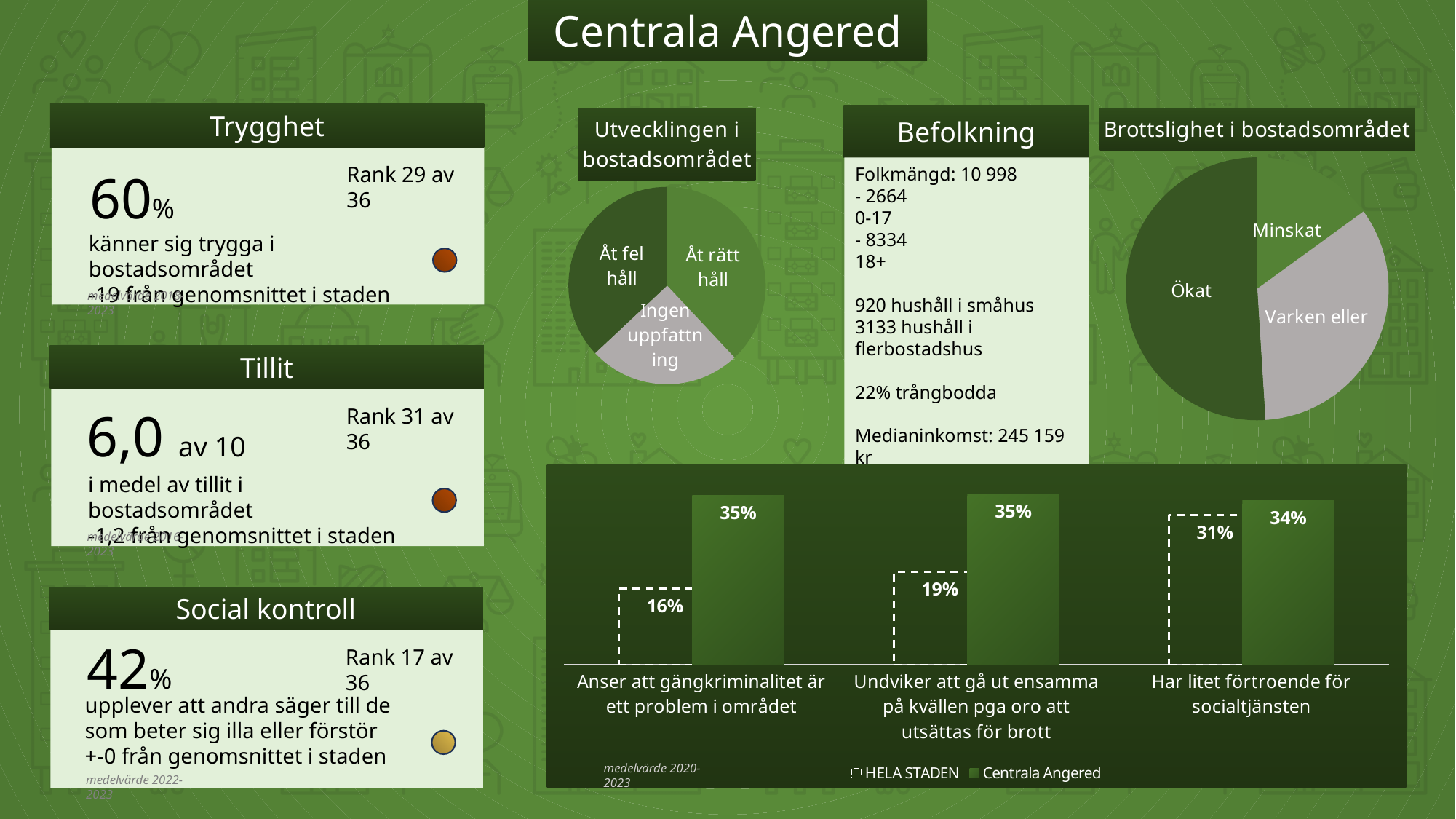
In the bar chart at the bottom, what is the value for Centrala Angered for 'Anser att gängkriminalitet är ett problem i området'? 35% In the bar chart at the bottom, what is the difference between Centrala Angered and HELA STADEN for 'Anser att gängkriminalitet är ett problem i området'? 19 percentage points In the bar chart at the bottom, what is the value for Centrala Angered for 'Har litet förtroende för socialtjänsten'? 34% How many series does the legend of the bar chart at the bottom list? 2 In the bar chart at the bottom, which category has the lowest HELA STADEN value? Anser att gängkriminalitet är ett problem i området In the bar chart at the bottom, what is the difference between Centrala Angered and HELA STADEN for 'Har litet förtroende för socialtjänsten'? 3 percentage points How many categories are shown in the bar chart at the bottom? 3 In the bar chart at the bottom, is the Centrala Angered value or the HELA STADEN value larger for 'Undviker att gå ut ensamma på kvällen pga oro att utsättas för brott'? Centrala Angered In the pie chart 'Brottslighet i bostadsområdet', which slice is the largest? Ökat In the bar chart at the bottom, what is the value for HELA STADEN for 'Undviker att gå ut ensamma på kvällen pga oro att utsättas för brott'? 19% In the bar chart at the bottom, which category has the highest HELA STADEN value? Har litet förtroende för socialtjänsten What kind of chart is 'Utvecklingen i bostadsområdet'? Pie chart